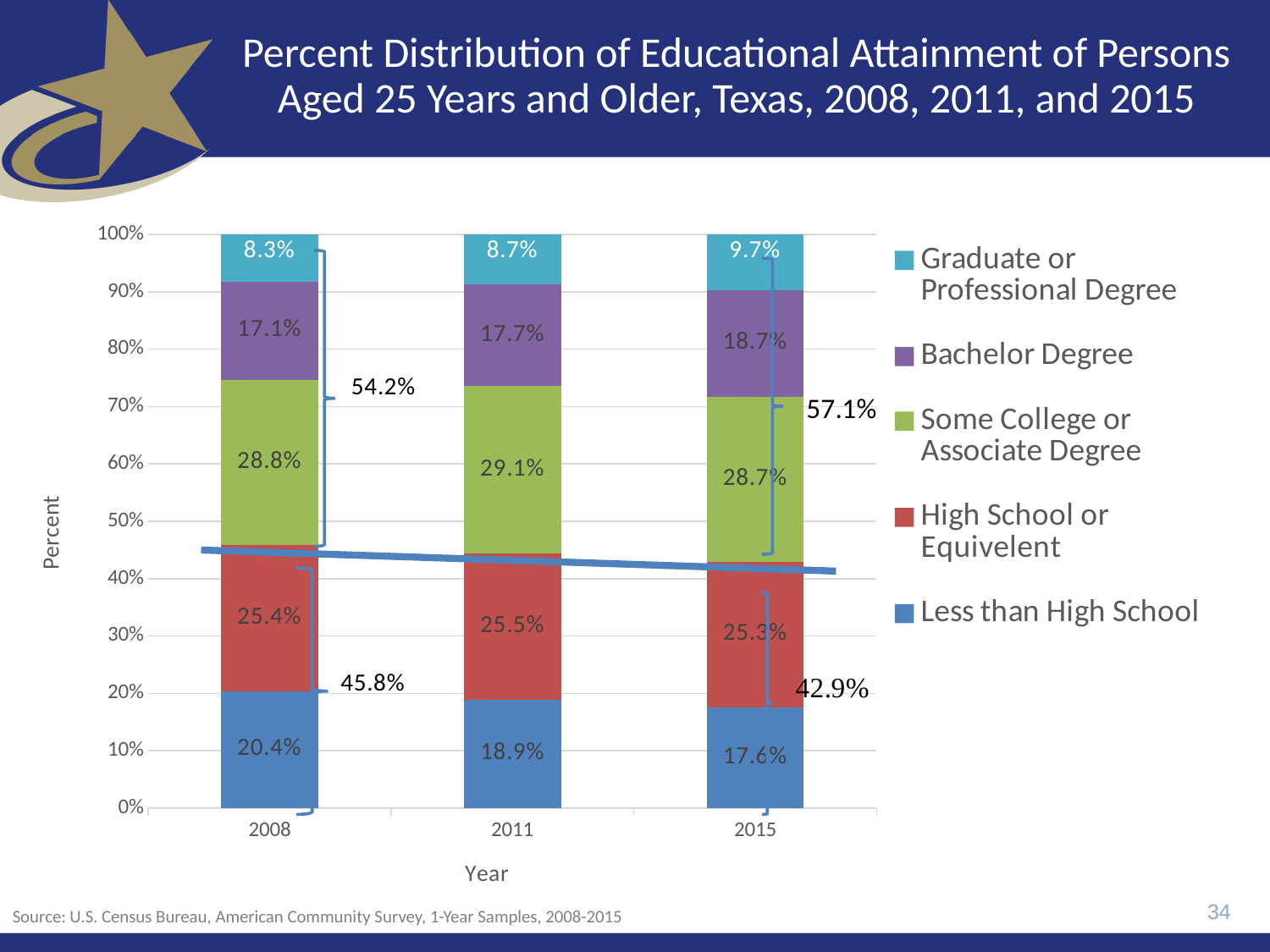
Does the Less than High School share rise or fall from 2008 to 2015? falls How many years are shown on the x axis? 3 What combined percentage is annotated beside the 2015 bar for the upper segments (Some College or Associate Degree and above)? 57.1% By how many percentage points did the Less than High School share change between 2008 (20.4%) and 2015 (17.6%)? 2.8 percentage points How many series does the legend list? 5 Which year has the larger Some College or Associate Degree share, 2011 or 2015? 2011 What percentage of persons aged 25 and older in Texas had less than a high school education in 2008? 20.4% What kind of chart is shown on the slide? stacked bar chart Does the Graduate or Professional Degree share rise or fall from 2008 to 2015? rises What is the value for Graduate or Professional Degree in 2015? 9.7% What is the value for Bachelor Degree in 2011? 17.7% Which educational attainment category has the largest share in 2008? Some College or Associate Degree